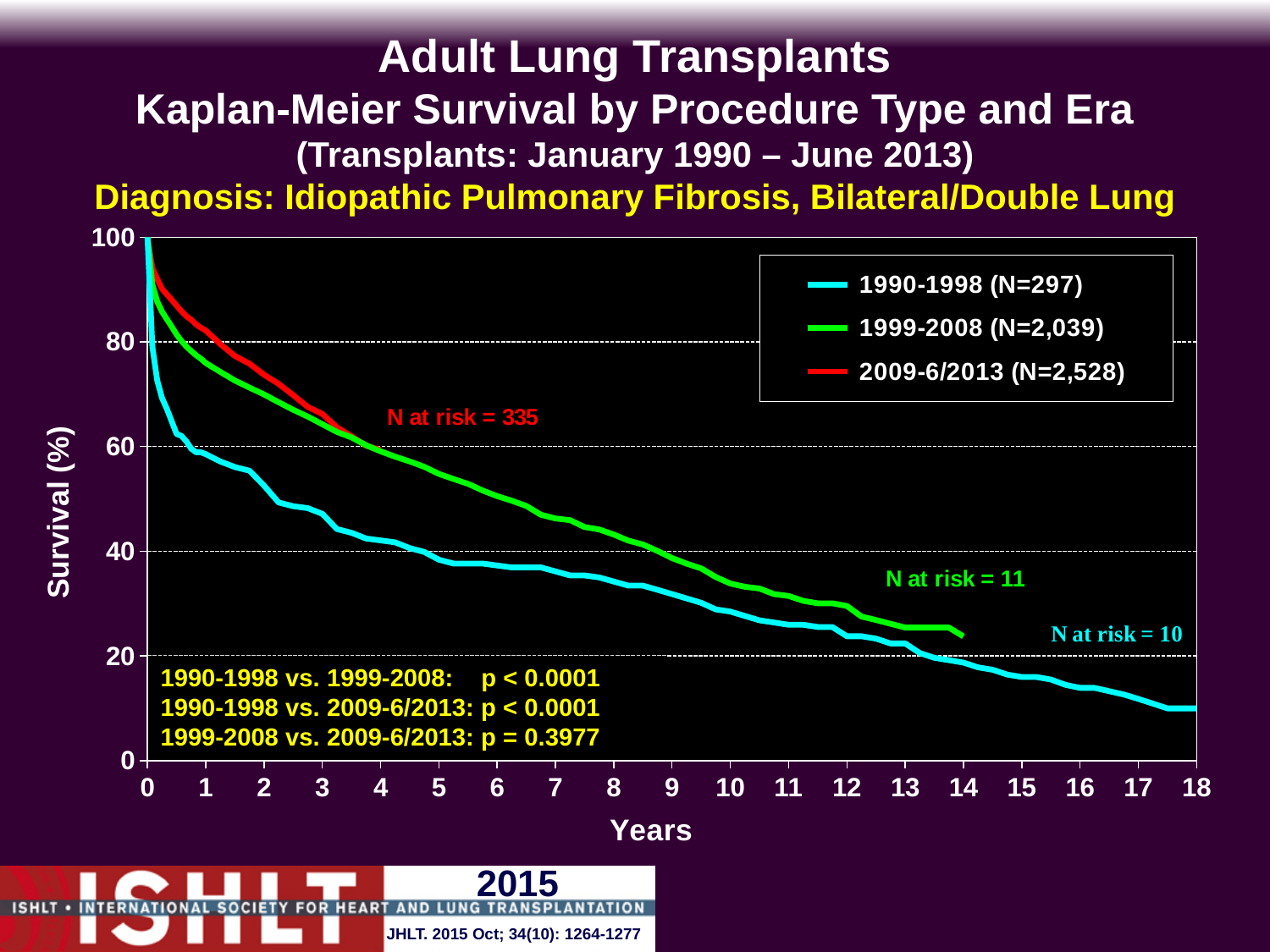
What is the difference in N between the 2009-6/2013 era and the 1999-2008 era? 489 At 5 years, which era has higher survival, 1990-1998 or 1999-2008? 1999-2008 How many series does the legend list? 3 At 5 years, is the survival for the 1999-2008 era greater or less than 40? greater What is the N for the 1999-2008 era shown in the legend? 2,039 What kind of chart is shown on the slide? line chart What is the p-value for 1999-2008 vs. 2009-6/2013? p = 0.3977 Do the survival curves rise or fall as years increase? fall At 10 years, is the survival for the 1990-1998 era greater or less than 40? less What colour is the line for the 1999-2008 era? green What is the N at risk printed for the 2009-6/2013 curve? 335 Which era has the largest number of transplants (N) in the legend? 2009-6/2013